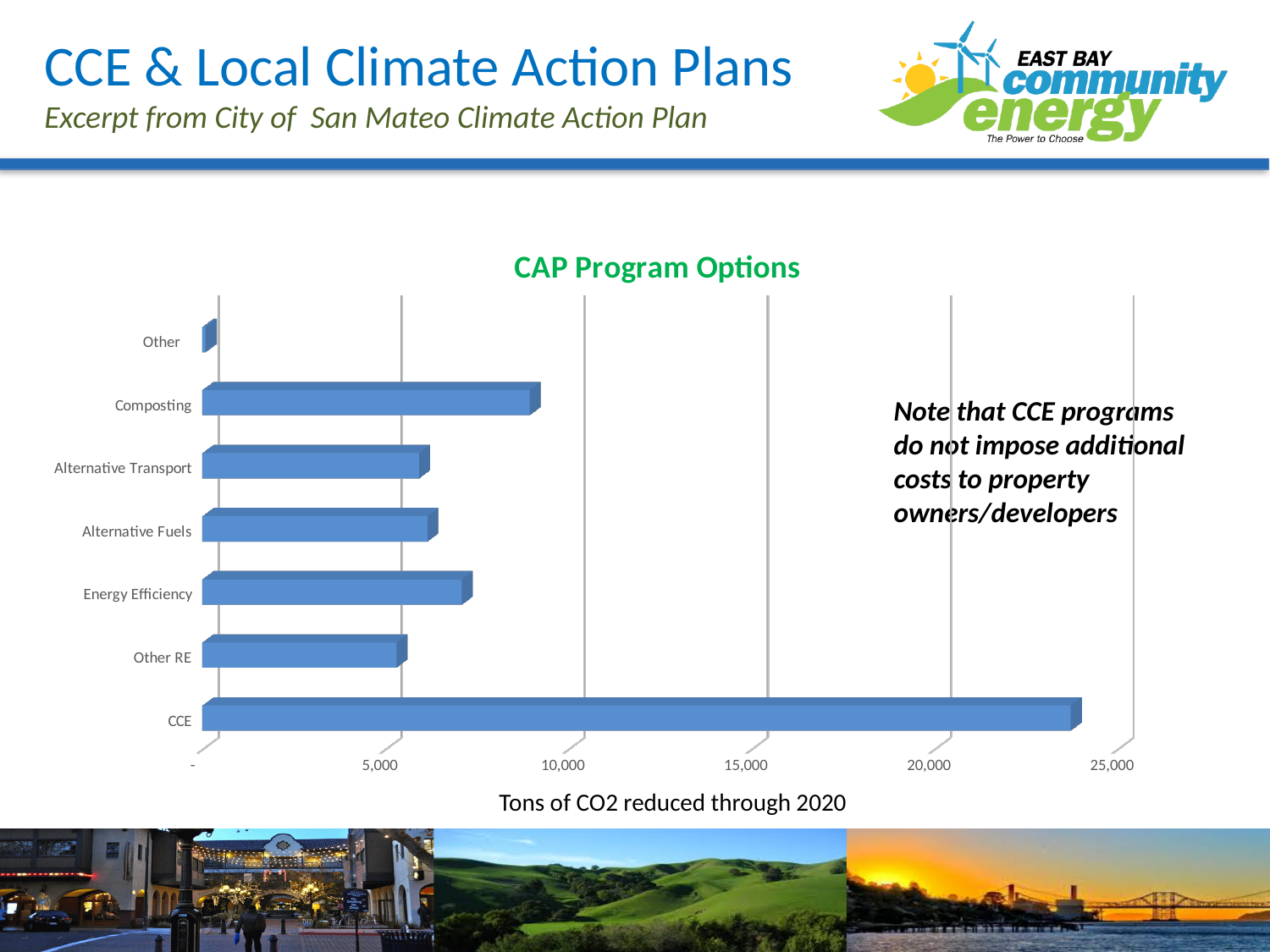
How many categories are plotted in the CAP Program Options chart? 7 Which category has the highest value in the CAP Program Options chart? CCE Is the value for Other greater or less than 5,000? less What kind of chart is shown on the slide? bar chart What is the title of the chart? CAP Program Options Is the value for Energy Efficiency greater or less than 5,000? greater Is the value for Composting greater or less than 10,000? less Which category has the lowest value in the CAP Program Options chart? Other Which is larger, the value for Energy Efficiency or the value for Other RE? Energy Efficiency Which is larger, the value for Composting or the value for Energy Efficiency? Composting What does the horizontal axis of the chart measure, according to the label below it? Tons of CO2 reduced through 2020